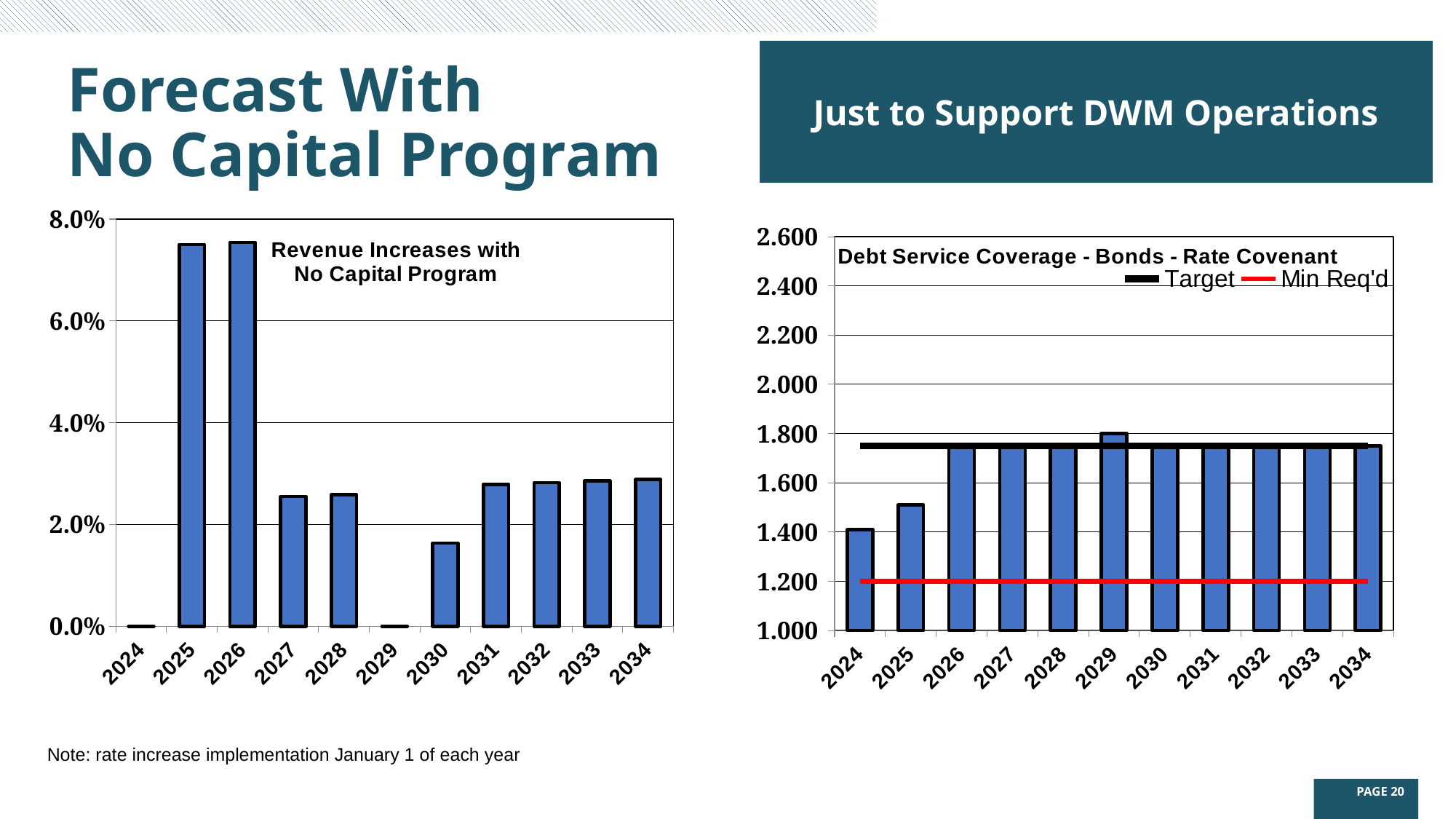
In the right chart, "Debt Service Coverage - Bonds - Rate Covenant", is the value for 2029 greater or less than 1.600? greater What type of chart is the left chart titled "Revenue Increases with No Capital Program"? bar chart In the right chart, "Debt Service Coverage - Bonds - Rate Covenant", which year has the lowest bar? 2024 In the left chart, "Revenue Increases with No Capital Program", which is larger, the value for 2026 or the value for 2028? 2026 In the left chart, "Revenue Increases with No Capital Program", is the value for 2027 greater or less than 2.0%? greater How many years are shown on the x axis of the left chart, "Revenue Increases with No Capital Program"? 11 In the right chart, "Debt Service Coverage - Bonds - Rate Covenant", is the value for 2025 greater or less than 1.600? less In the right chart, "Debt Service Coverage - Bonds - Rate Covenant", what colour is the Min Req'd line? red In the right chart, "Debt Service Coverage - Bonds - Rate Covenant", which year has the highest bar? 2029 How many series does the legend of the right chart, "Debt Service Coverage - Bonds - Rate Covenant", list? 2